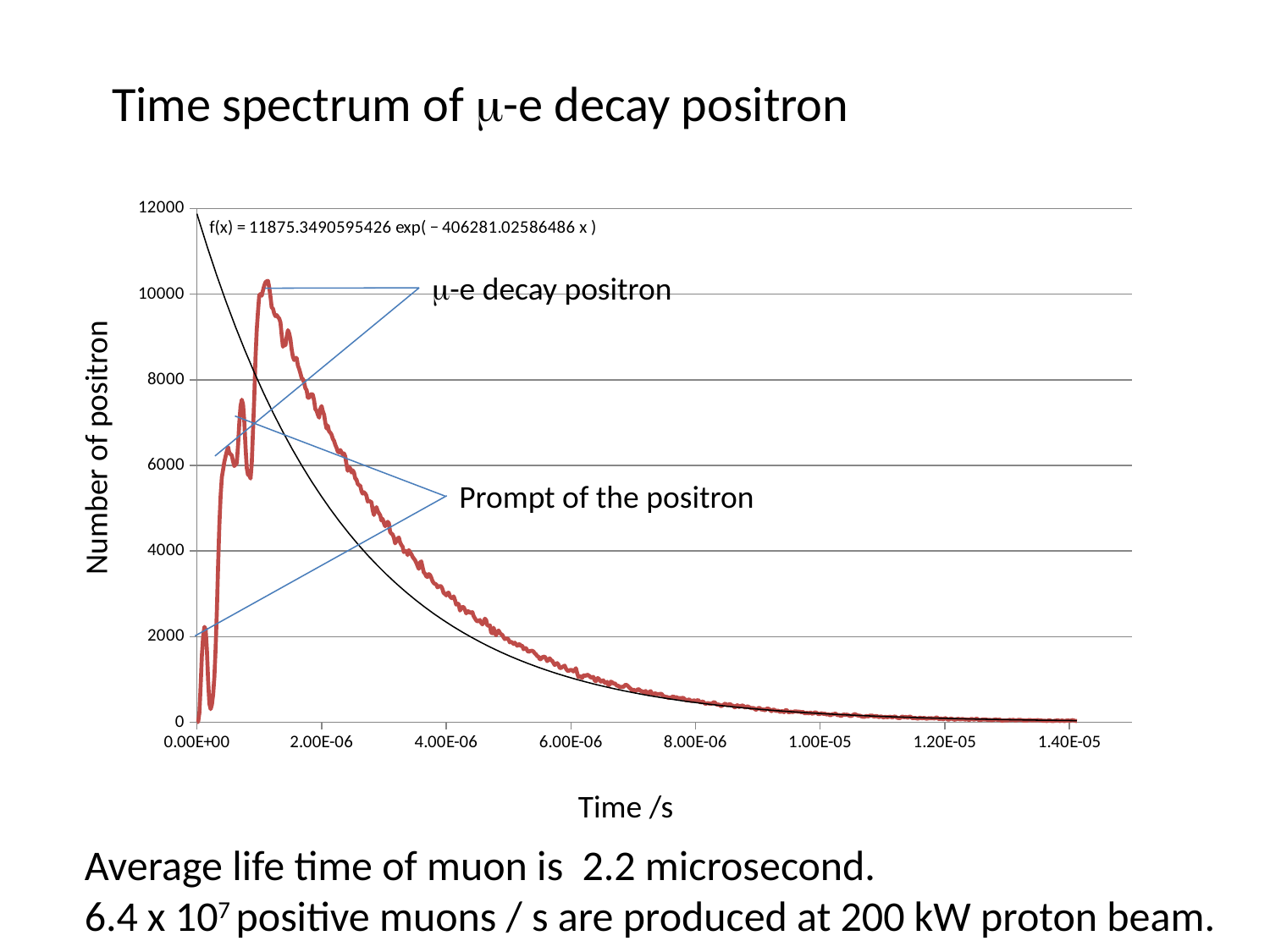
What kind of chart is shown on the slide? line chart What is the title of the chart on the slide? Time spectrum of μ-e decay positron After its peak near 1.00E-06 s, does the red data curve rise or fall as time increases? fall Is the value of the red data curve at 8.00E-06 s greater or less than 2000? less What is the fitted function displayed on the chart? f(x) = 11875.3490595426 exp( − 406281.02586486 x ) What is the label of the vertical axis? Number of positron Which feature of the curve is labelled 'Prompt of the positron': the early narrow spikes or the broad peak? the early narrow spikes What is the largest tick value shown on the horizontal axis? 1.40E-05 Is the peak value of the red data curve greater or less than 8000? greater What is the highest value shown on the vertical axis? 12000 Is the value of the red data curve at 4.00E-06 s greater or less than 2000? greater